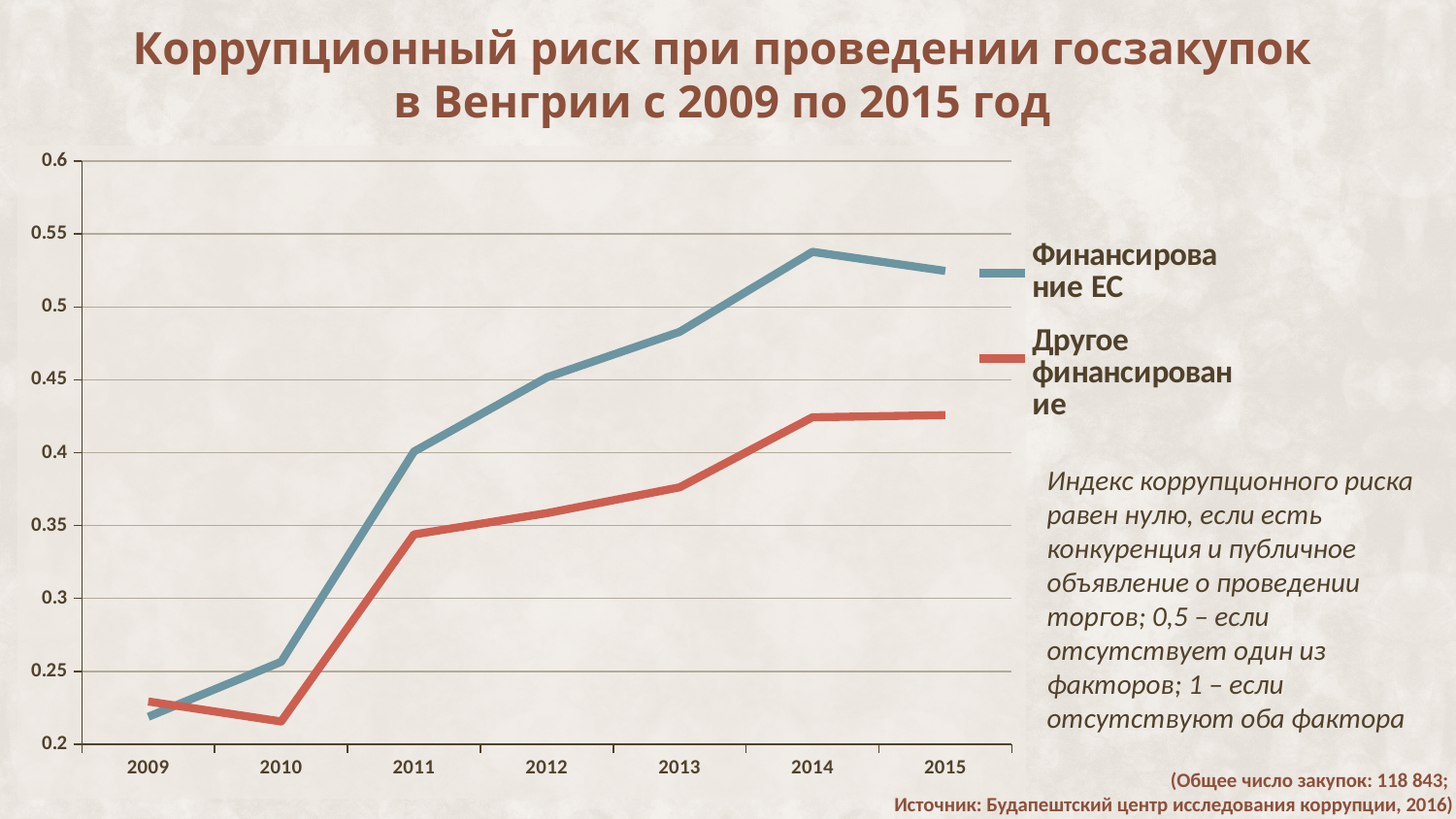
In which year is the 'Другое финансирование' series at its lowest? 2010 How many series does the legend list? 2 Is the value for 'Финансирование ЕС' in 2014 greater or less than 0.5? greater Is the value for 'Финансирование ЕС' in 2009 greater or less than 0.25? less In which year does the 'Финансирование ЕС' series reach its highest value? 2014 What kind of chart is shown on the slide? line chart In which year is the 'Финансирование ЕС' series at its lowest? 2009 Which series is drawn in red? Другое финансирование In 2013, which series has the higher value, 'Финансирование ЕС' or 'Другое финансирование'? Финансирование ЕС Does the 'Финансирование ЕС' series generally rise or fall from 2009 to 2014? rise How many years are plotted along the x axis? 7